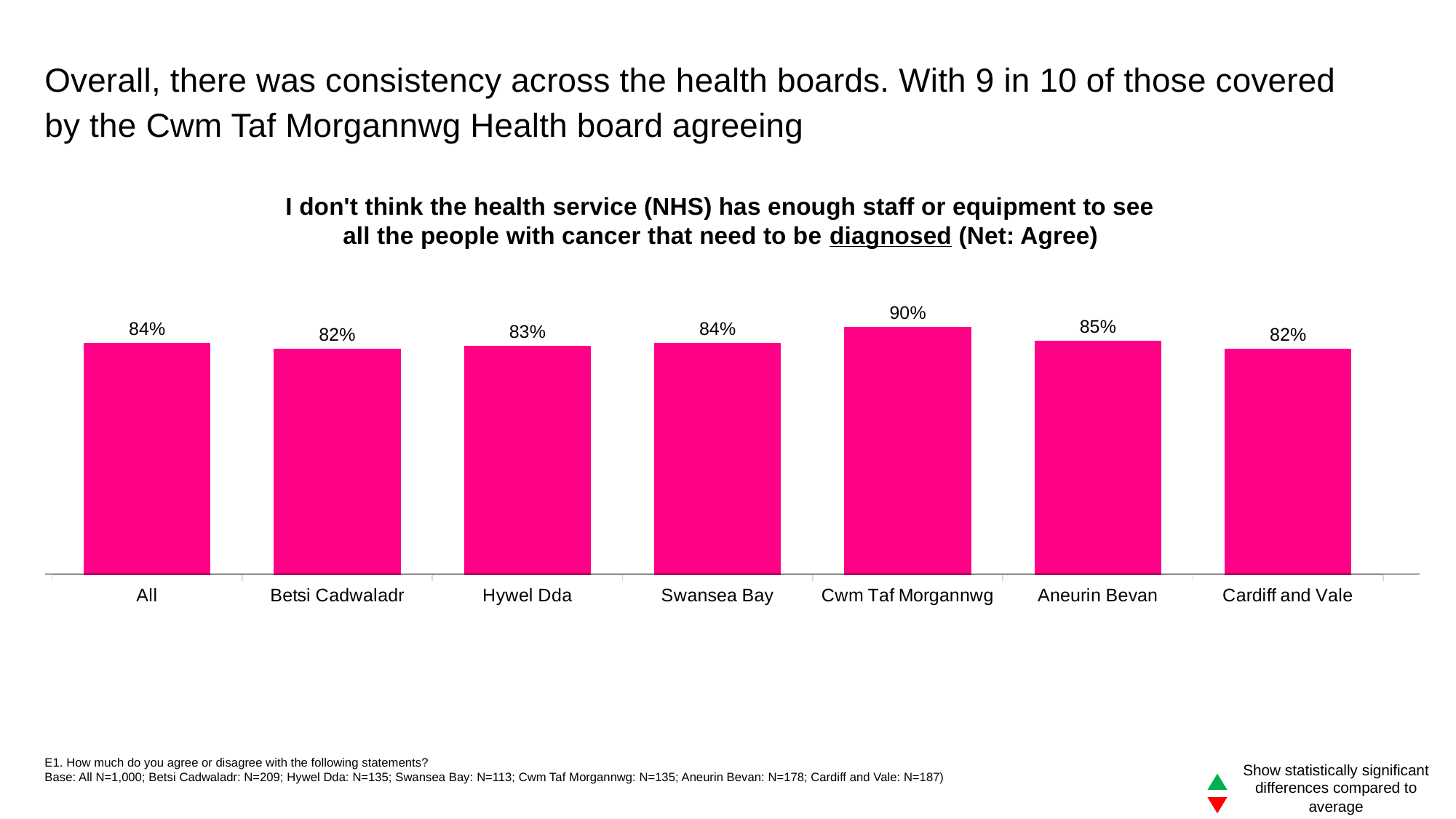
What colour are the bars in the chart? Pink What is the value for Aneurin Bevan? 85% Which is larger, the value for Swansea Bay or the value for Hywel Dda? Swansea Bay Which health board has the highest value? Cwm Taf Morgannwg Which two health boards share the lowest value of 82%? Betsi Cadwaladr and Cardiff and Vale What is the difference between the values for Cwm Taf Morgannwg and Hywel Dda? 7 percentage points What is the value for the All category? 84% What is the value for Cwm Taf Morgannwg? 90% What is the difference between the values for Aneurin Bevan and Cardiff and Vale? 3 percentage points What is the value for Betsi Cadwaladr? 82% What kind of chart is shown on the slide? Bar chart How many categories are shown on the x axis? 7